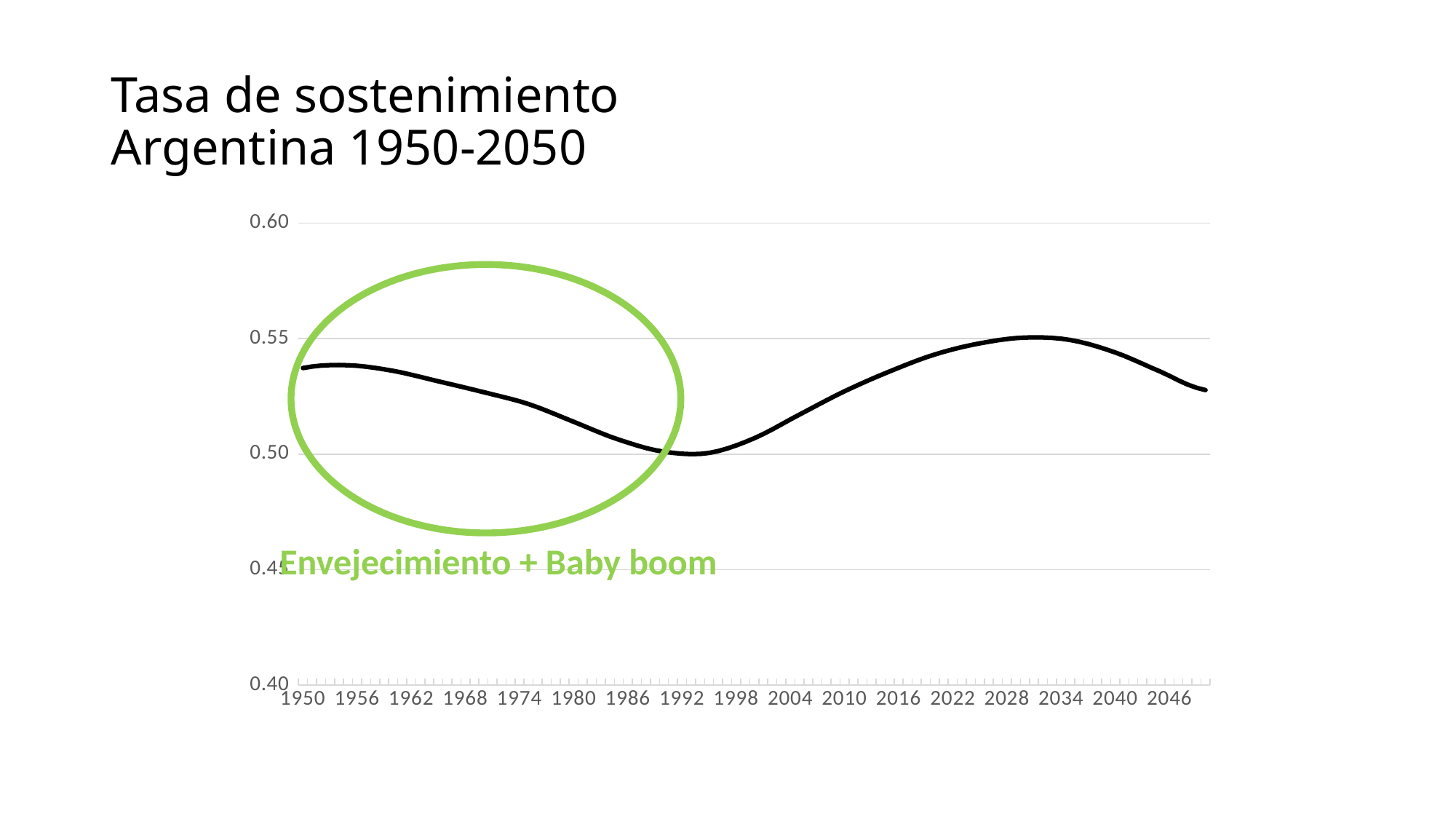
Is the value for 2046 greater or less than 0.55? less What text is written in green below the circled part of the chart? Envejecimiento + Baby boom What kind of chart is shown on the slide? line chart Is the value for 2010 greater or less than 0.50? greater What is the title of the chart on the slide? Tasa de sostenimiento Argentina 1950-2050 Is the value for 1950 greater or less than 0.55? less Does the line rise or fall between 1998 and 2028? rise Does the line rise or fall between 1950 and 1992? fall Does the line rise or fall between 2034 and 2046? fall Which year has the larger value, 1950 or 1992? 1950 How many lines (series) are plotted on the chart? 1